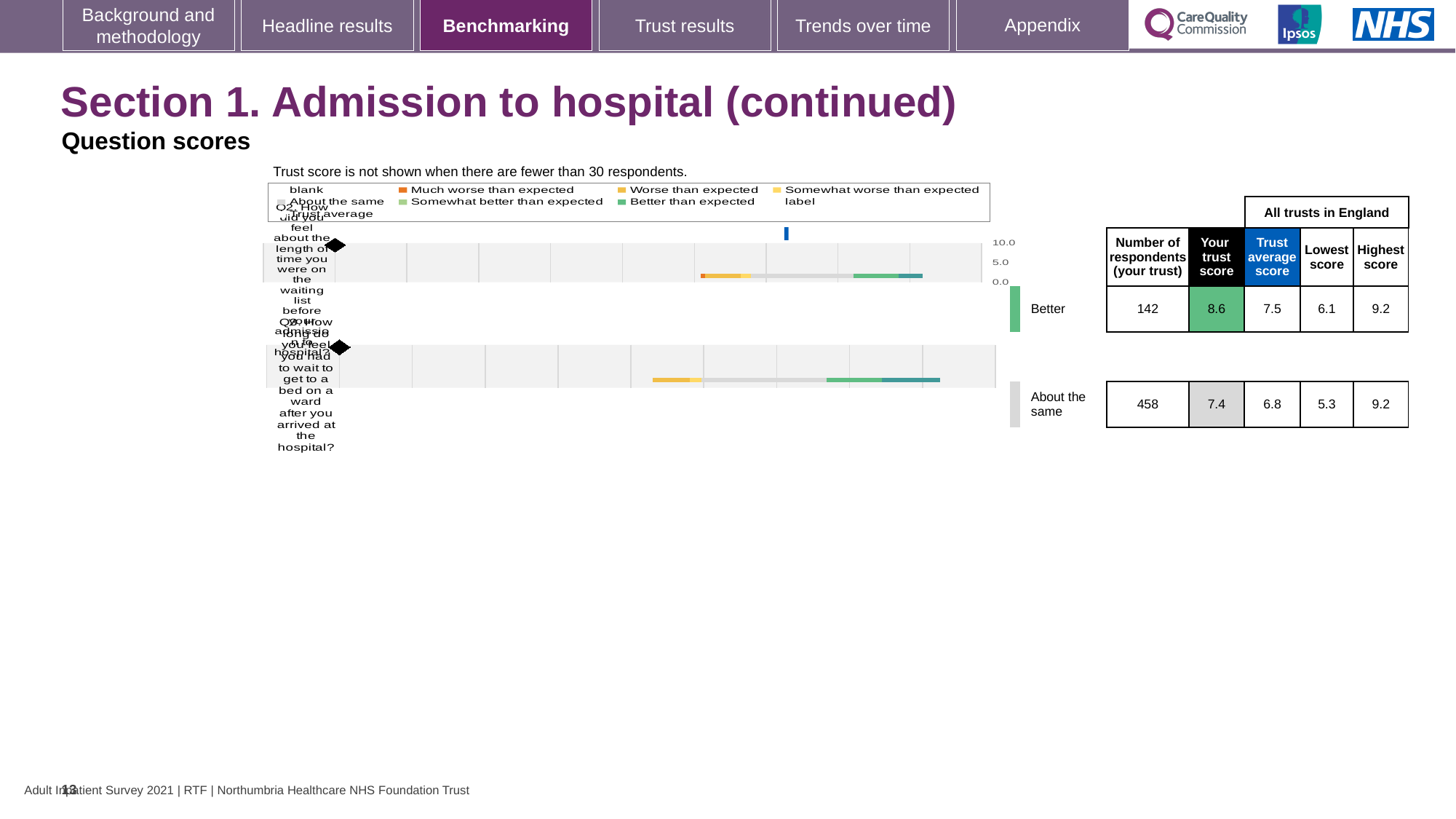
What is the trust score for Q2 (how did you feel about the length of time you were on the waiting list before admission to hospital)? 8.6 What is the trust score for Q3 (how long did you feel you had to wait to get to a bed on a ward after you arrived at the hospital)? 7.4 How is the trust's result for Q2 categorised relative to expectations? Better How is the trust's result for Q3 categorised relative to expectations? About the same What is the lowest score among all trusts in England for Q2? 6.1 What is the difference between the trust score and the trust average score for Q2? 1.1 How many respondents from the trust answered Q3? 458 What is the trust average score across all trusts in England for Q2? 7.5 What is the highest score among all trusts in England for Q3? 9.2 Which question has the higher trust score, Q2 or Q3? Q2 What is the difference between the trust score and the trust average score for Q3? 0.6 What is the trust average score across all trusts in England for Q3? 6.8